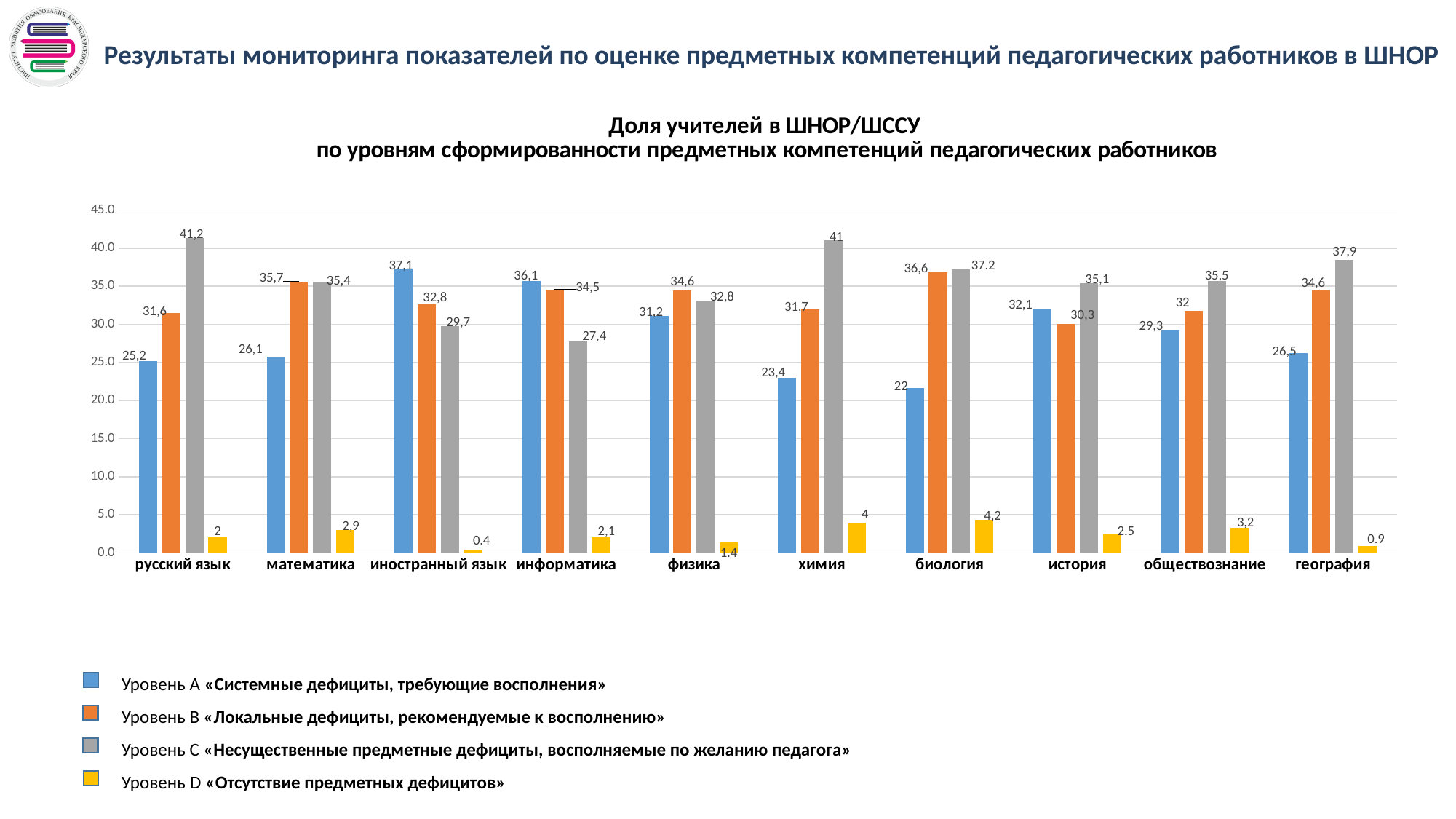
Which level has the lowest value for химия? Уровень D What is the value of Уровень B for география? 34,6 For физика, which is larger: Уровень A or Уровень B? Уровень B How many subject categories are shown on the x axis of the chart? 10 Is the value of Уровень C for география greater or less than 35? greater What is the difference between Уровень C and Уровень A for химия? 17,6 What is the value of Уровень C for русский язык? 41,2 What is the value of Уровень A for иностранный язык? 37,1 What type of chart is shown on the slide? bar chart How many series (levels) does the legend list? 4 What is the value of Уровень D for биология? 4,2 Which level has the highest value for русский язык? Уровень C